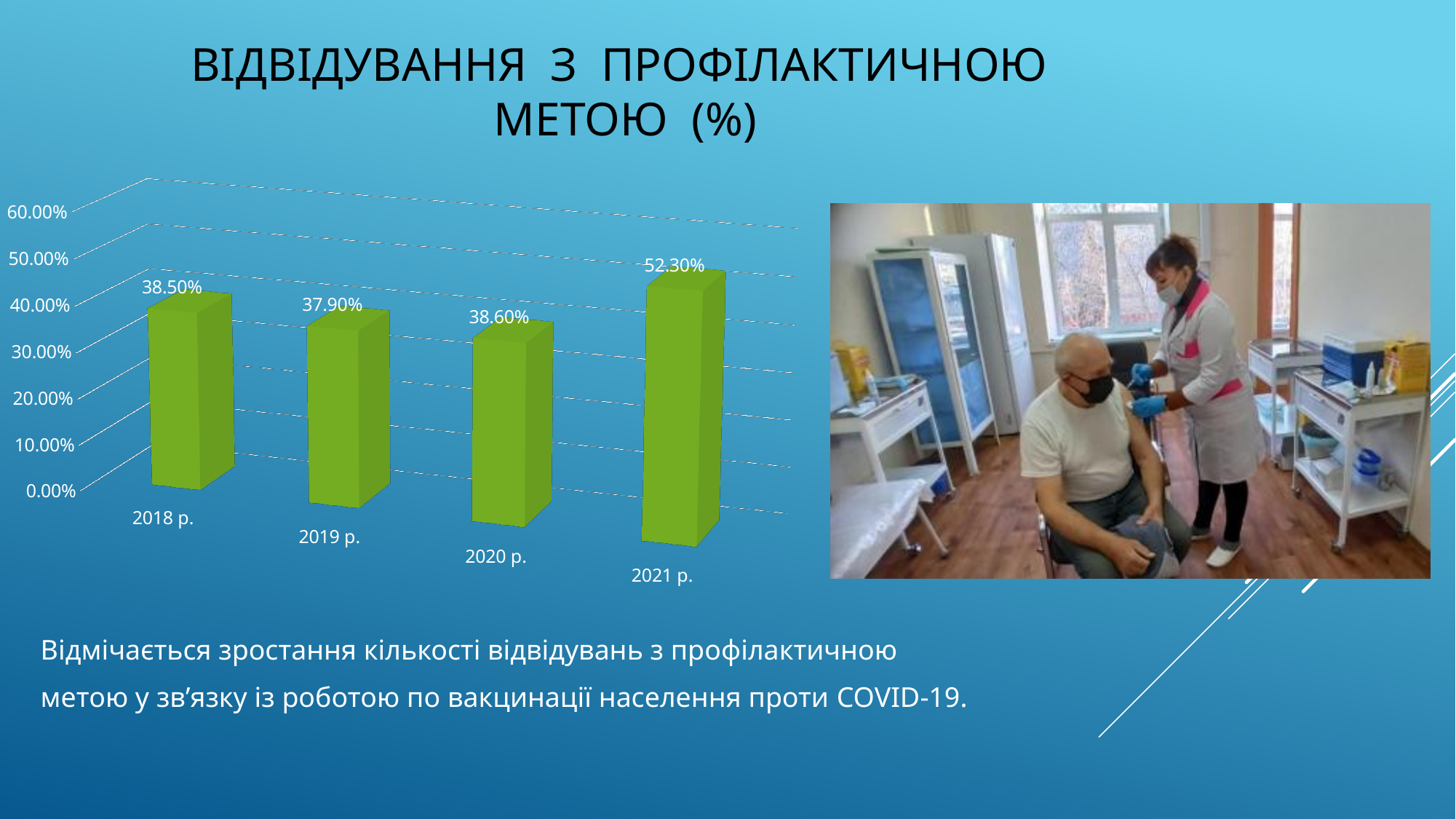
What is the difference between the values for 2021 р. and 2020 р.? 13.70% How many years are shown on the chart? 4 Does the value rise or fall from 2020 р. to 2021 р.? rise What kind of chart is shown on the slide? bar chart What is the value for 2018 р.? 38.50% Is the value for 2021 р. greater or less than 50.00%? greater Which year has the lowest value? 2019 р. What is the value for 2020 р.? 38.60% What is the value for 2021 р.? 52.30% What is the value for 2019 р.? 37.90% Which year has the highest value? 2021 р. Which is larger, the value for 2018 р. or the value for 2021 р.? 2021 р.